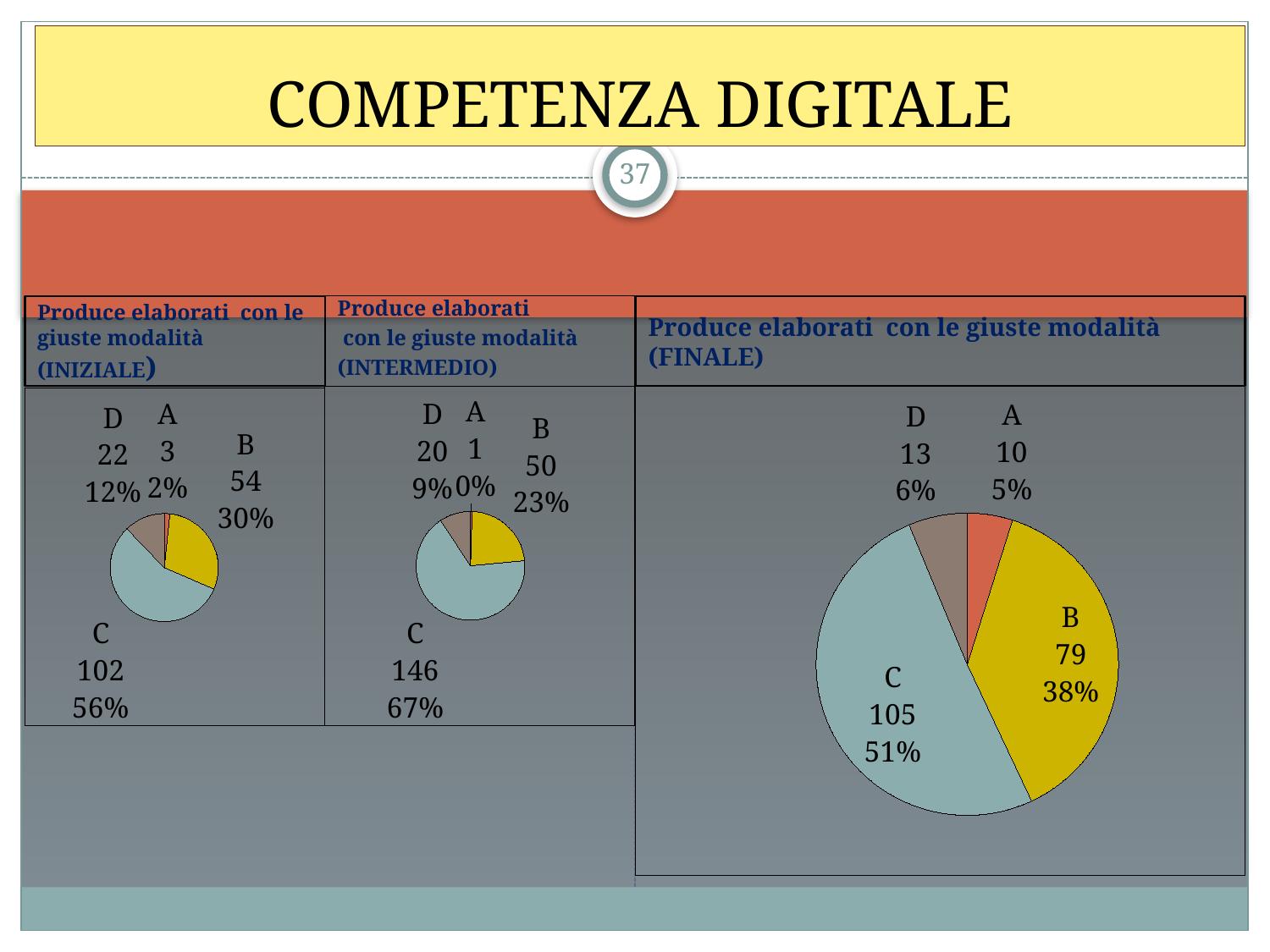
How many categories does the FINALE pie chart show? 4 In the INTERMEDIO pie chart, what share of the pie does category C represent? 67% In the INIZIALE pie chart, what is the value for category C? 102 In the FINALE pie chart, which category has the highest value? C In the INIZIALE pie chart, what share of the pie does category B represent? 30% In the INTERMEDIO pie chart, what is the value for category B? 50 What kind of chart is used in the INIZIALE panel? Pie chart In the INTERMEDIO pie chart, which category has the lowest value? A In the FINALE pie chart, what is the value for category D? 13 What is the title of the chart on the right side of the slide? Produce elaborati con le giuste modalità (FINALE) In the FINALE pie chart, which is larger, the value for A or the value for D? D In the FINALE pie chart, what is the difference between the values for C and B? 26